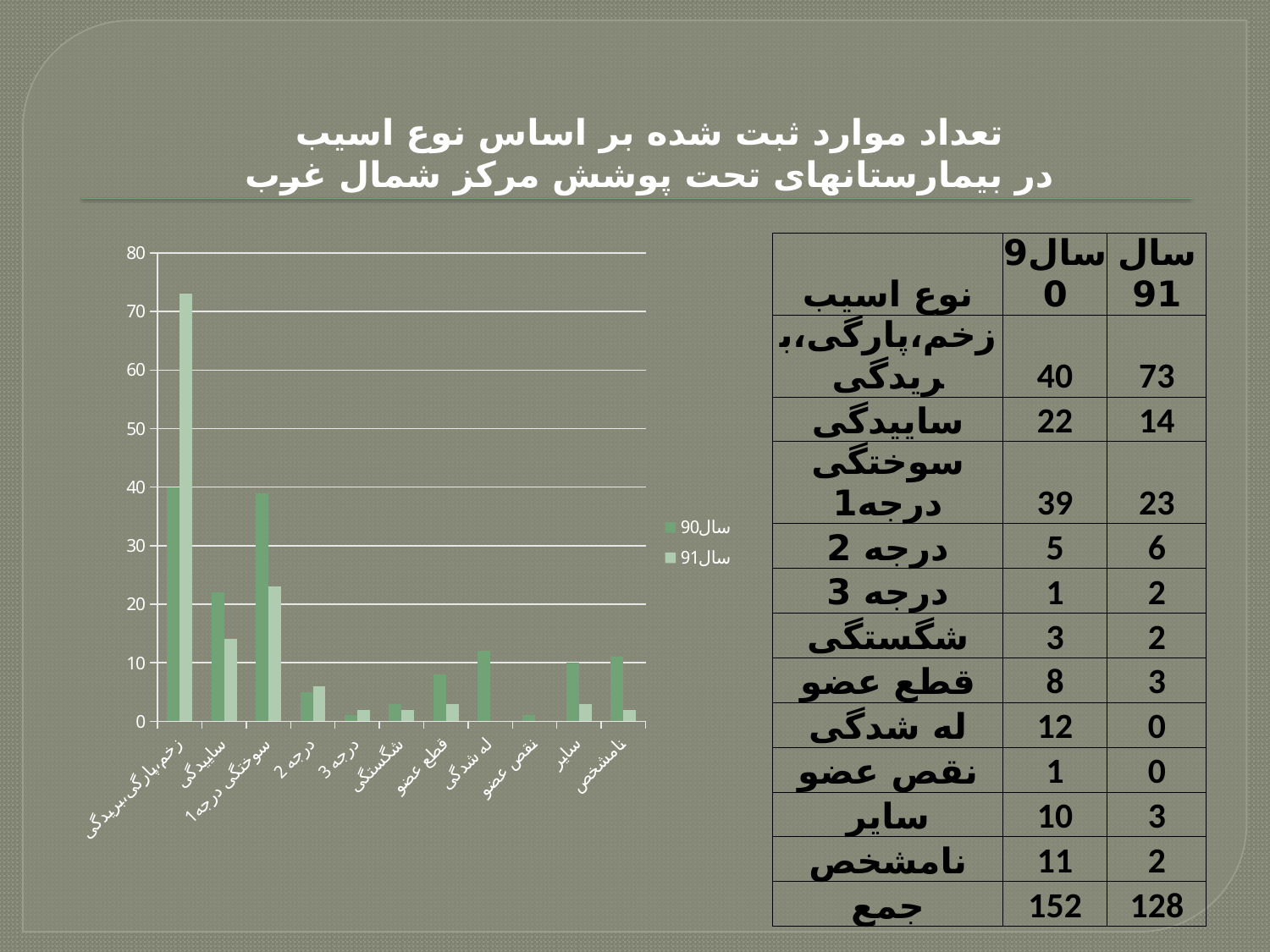
What are the two series named in the chart legend? سال90 and سال91 What is the value for زخم،پارگی،بریدگی in the سال91 series? 73 For ساییدگی, which series has the larger value, سال90 or سال91? سال90 What is the total of the سال90 series across all categories? 152 What kind of chart is shown on the slide? bar chart For سوختگی درجه1, which series has the larger value, سال90 or سال91? سال90 What is the difference between the سال90 and سال91 values for سایر? 7 How many injury-type categories are plotted along the x axis of the chart? 11 Is the سال90 value for زخم،پارگی،بریدگی greater or less than 30? greater Which category has the tallest bar in the chart? زخم،پارگی،بریدگی How many series does the chart legend list? 2 What is the value for له شدگی in the سال91 series? 0